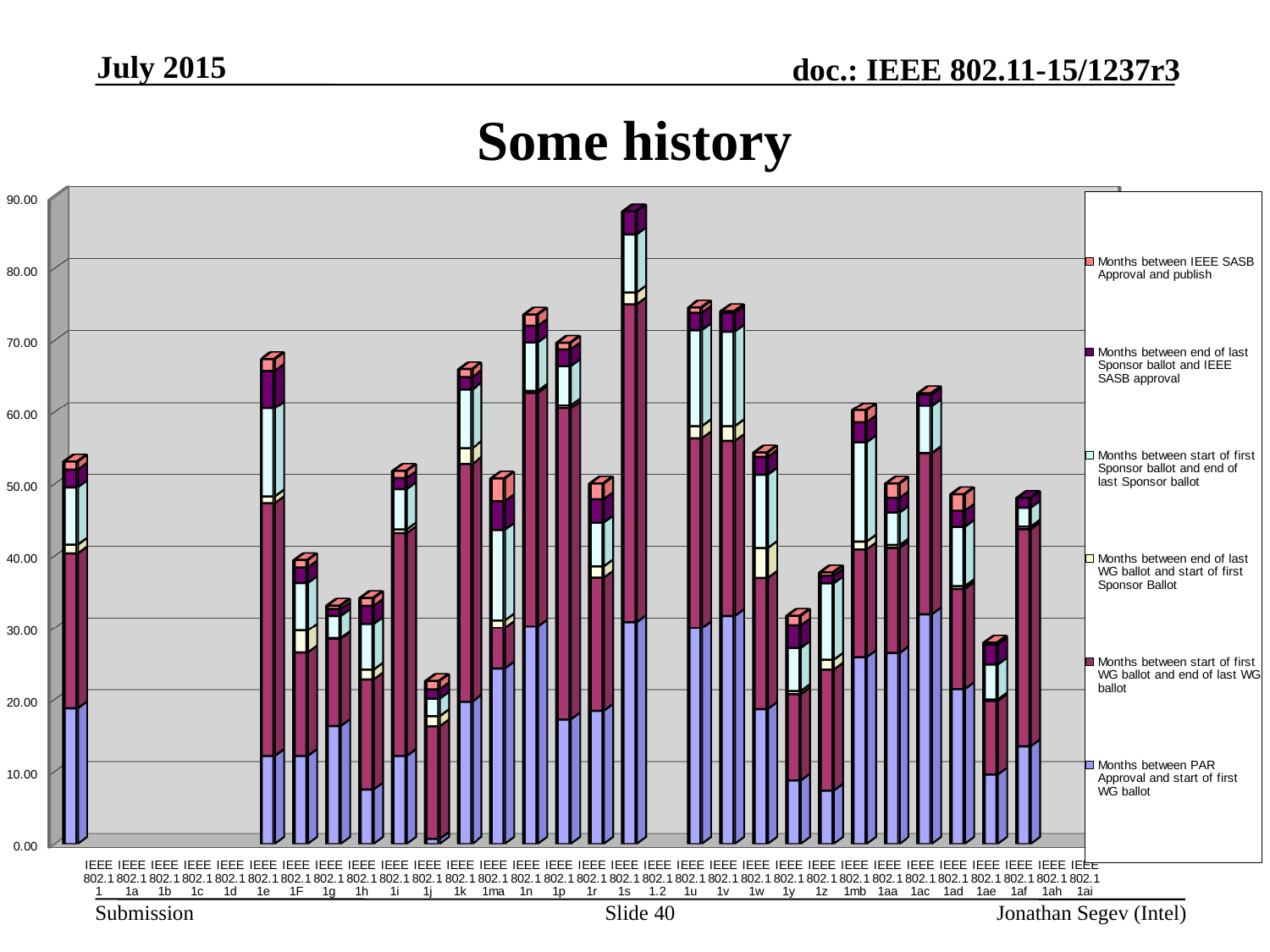
Which legend entry is shown at the bottom of the legend? Months between PAR Approval and start of first WG ballot Is the total stacked value for IEEE 802.1 1j greater or less than 30? less What is the highest value shown on the y axis? 90.00 What kind of chart is shown on the slide? stacked bar chart Which category has the tallest stacked bar? IEEE 802.11s Is the total stacked value for IEEE 802.1 1s greater or less than 80? greater Is the total stacked value for IEEE 802.1 1y greater or less than 40? less How many series does the legend list? 6 What is the title of the chart? Some history Among the categories with a visible bar, which has the shortest stacked bar? IEEE 802.11j Which has the taller stacked bar, IEEE 802.1 1e or IEEE 802.1 1F? IEEE 802.11e